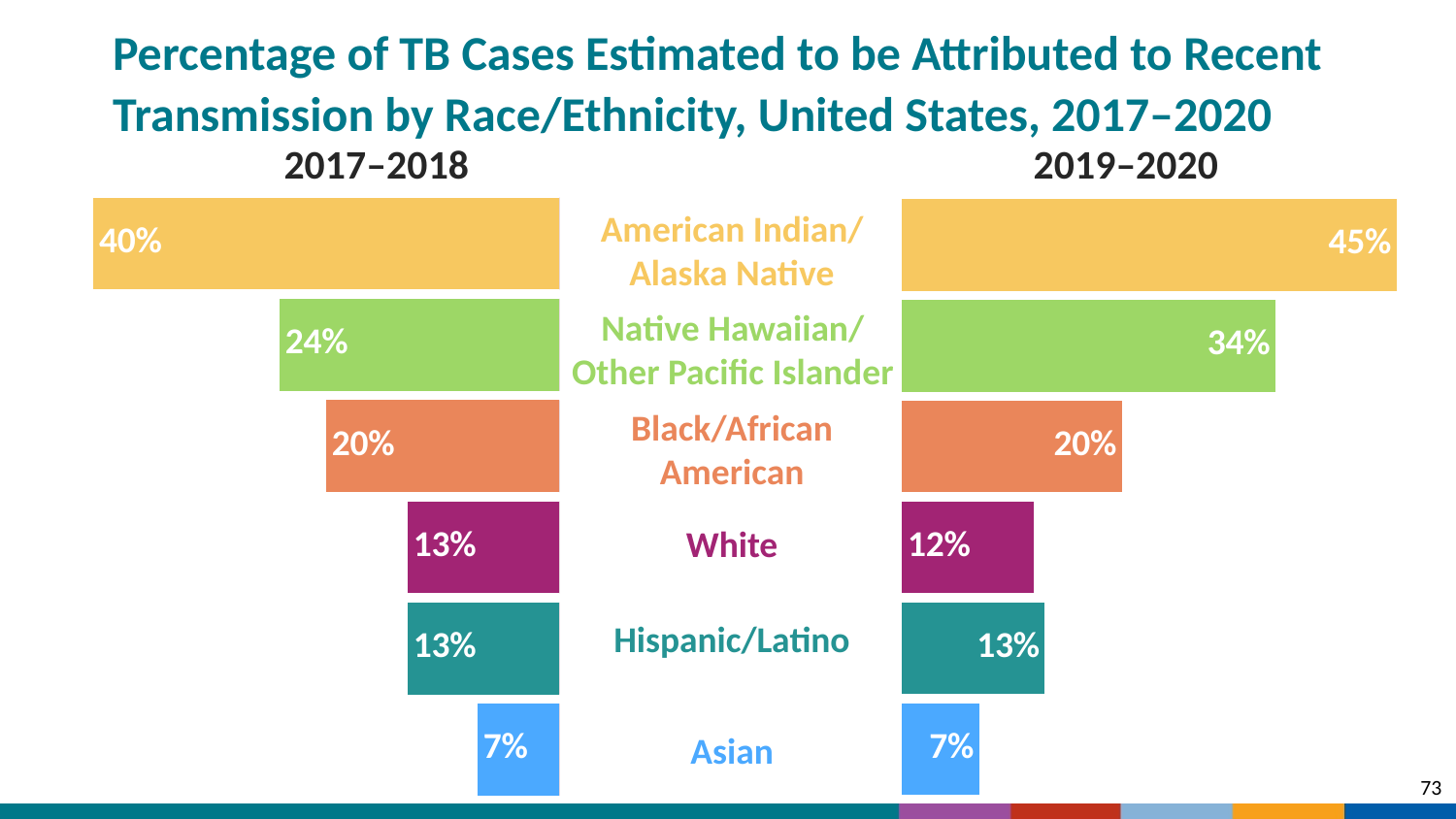
What is the value for American Indian/Alaska Native in 2017–2018? 40% Which is larger in 2017–2018: Native Hawaiian/Other Pacific Islander or Black/African American? Native Hawaiian/Other Pacific Islander Which two time periods are compared on the chart? 2017–2018 and 2019–2020 What is the difference between the American Indian/Alaska Native and Asian values in 2019–2020? 38% Which race/ethnicity has the lowest value in 2017–2018? Asian What is the value for Native Hawaiian/Other Pacific Islander in 2019–2020? 34% Which is larger for Black/African American: the 2017–2018 value or the 2019–2020 value? They are equal (20%) What is the difference between the 2019–2020 and 2017–2018 values for Native Hawaiian/Other Pacific Islander? 10% Which race/ethnicity has the highest value in 2019–2020? American Indian/Alaska Native How many race/ethnicity categories are shown on the chart? 6 What kind of chart is shown on the slide? Bar chart What is the value for White in 2019–2020? 12%